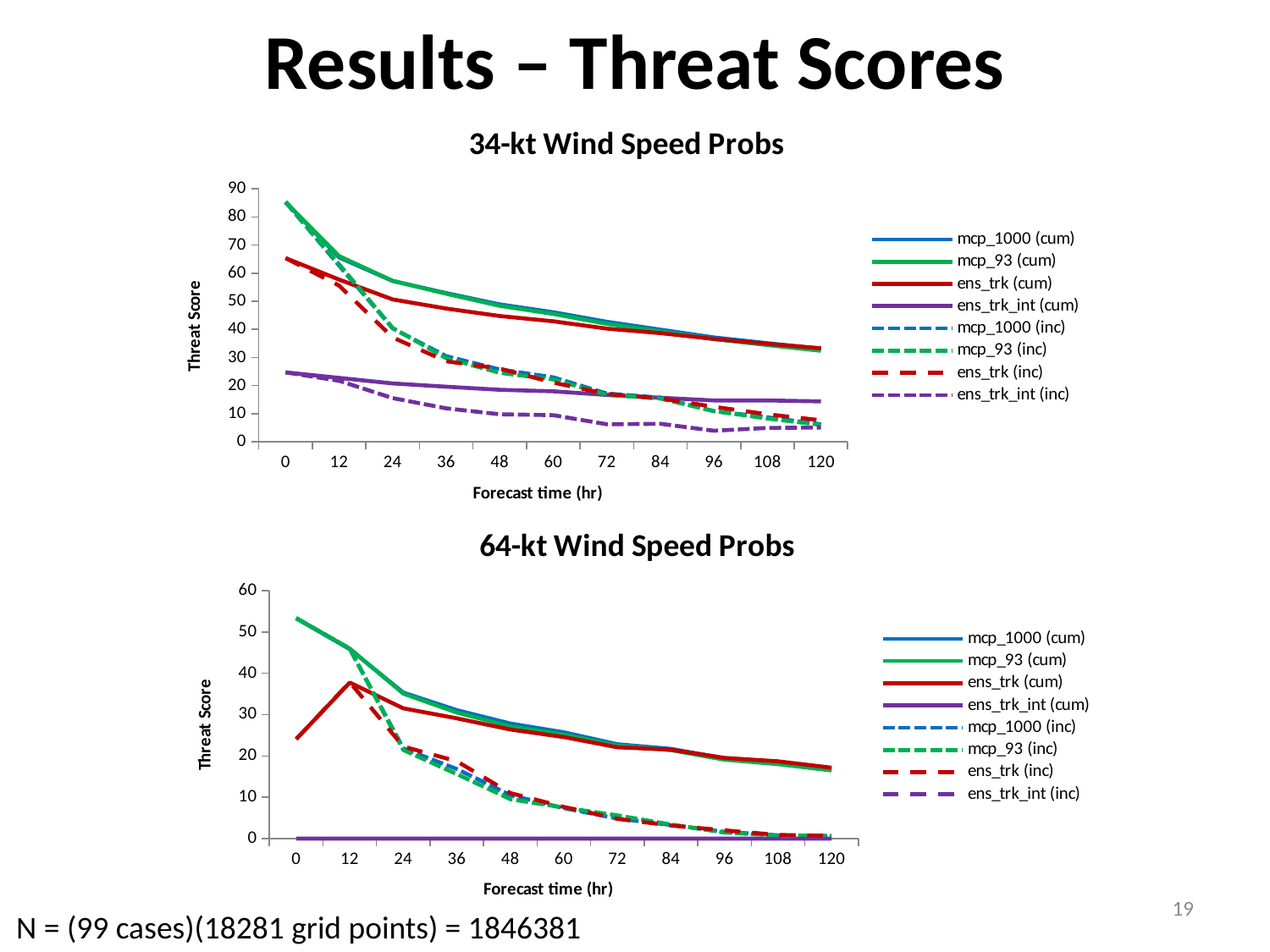
In the '64-kt Wind Speed Probs' chart, is the value of mcp_93 (cum) at forecast time 0 greater or less than 50? greater What type of chart is the '34-kt Wind Speed Probs' chart? line chart In the '34-kt Wind Speed Probs' chart, is the value of ens_trk_int (cum) at forecast time 0 greater or less than 30? less In the '34-kt Wind Speed Probs' chart, is the value of mcp_93 (cum) at forecast time 0 greater or less than 80? greater In the '34-kt Wind Speed Probs' chart, does the mcp_93 (cum) series rise or fall as forecast time increases? fall What is the x-axis label of the '34-kt Wind Speed Probs' chart? Forecast time (hr) How many series does the legend of the '34-kt Wind Speed Probs' chart list? 8 What is the y-axis label of the '64-kt Wind Speed Probs' chart? Threat Score In the '34-kt Wind Speed Probs' chart, which series is higher at forecast time 0: mcp_93 (cum) or ens_trk (cum)? mcp_93 (cum) How many forecast time tick labels are shown on the x axis of the '64-kt Wind Speed Probs' chart? 11